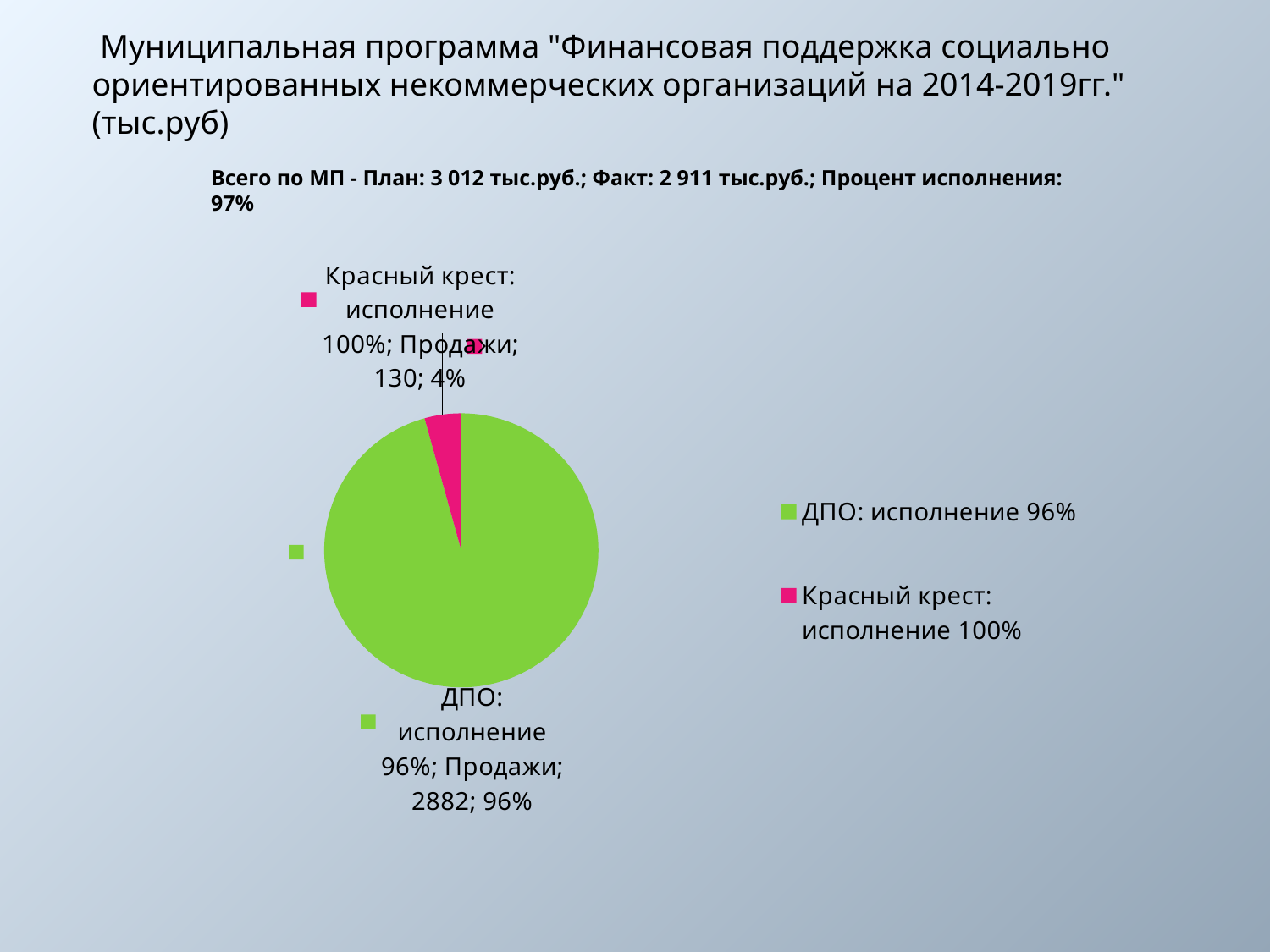
What kind of chart is shown on the slide? pie chart What is the value shown for the slice "Красный крест: исполнение 100%"? 130 What is the value shown for the slice "ДПО: исполнение 96%"? 2882 Which is larger, the value for "ДПО: исполнение 96%" or the value for "Красный крест: исполнение 100%"? ДПО: исполнение 96% How many entries does the legend of the pie chart list? 2 What share of the pie does the slice "Красный крест: исполнение 100%" represent? 4% What colour is the slice for "Красный крест: исполнение 100%" in the pie chart? pink (magenta) Which slice of the pie chart is the largest? ДПО: исполнение 96% What share of the pie does the slice "ДПО: исполнение 96%" represent? 96% Which slice of the pie chart is the smallest? Красный крест: исполнение 100% How many slices does the pie chart have? 2 What is the difference between the values for "ДПО: исполнение 96%" and "Красный крест: исполнение 100%"? 2752